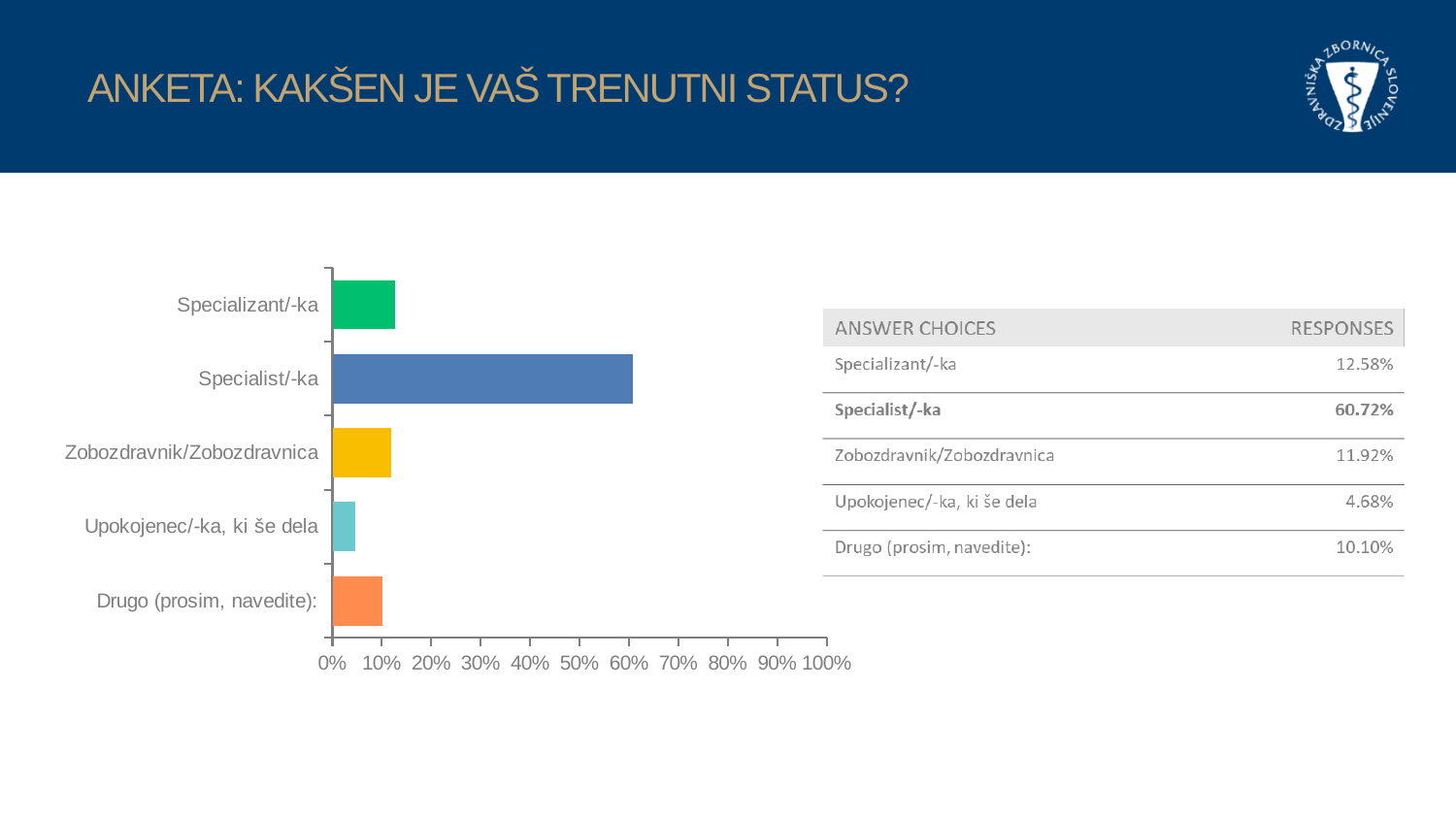
Is the value for Upokojenec/-ka, ki še dela greater or less than 10%? less How many categories does the bar chart show? 5 According to the table, what is the response share for Specializant/-ka? 12.58% Which category has the lowest value in the bar chart? Upokojenec/-ka, ki še dela Which category has the highest value in the bar chart? Specialist/-ka What is the difference between the values for Specialist/-ka and Specializant/-ka as given in the table? 48.14% According to the table, what is the response share for Drugo (prosim, navedite):? 10.10% Which is larger, the value for Specializant/-ka or the value for Upokojenec/-ka, ki še dela? Specializant/-ka What kind of chart is shown on the slide? bar chart Is the value for Specialist/-ka greater or less than 50%? greater According to the table, what is the response share for Upokojenec/-ka, ki še dela? 4.68% According to the table, what is the response share for Specialist/-ka? 60.72%